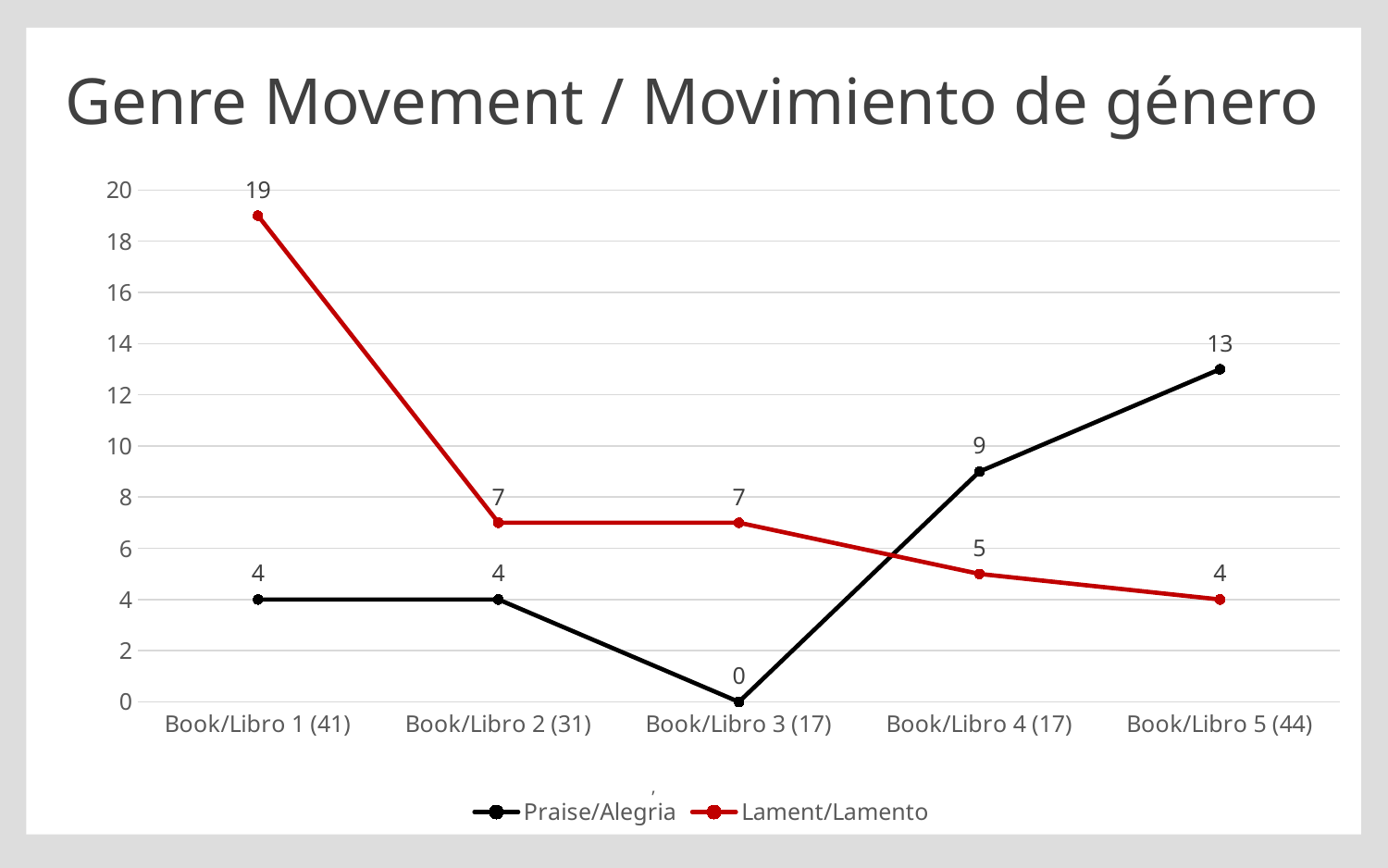
What is the Praise/Alegria value for Book/Libro 3 (17)? 0 Does the Lament/Lamento series rise or fall from Book/Libro 1 (41) to Book/Libro 5 (44)? Fall What kind of chart is shown on the slide? Line chart Which series has the larger value for Book/Libro 4 (17), Praise/Alegria or Lament/Lamento? Praise/Alegria How many categories are shown on the x axis? 5 What is the difference between the Lament/Lamento and Praise/Alegria values for Book/Libro 1 (41)? 15 Which category has the lowest Lament/Lamento value? Book/Libro 5 (44) Which category has the highest Praise/Alegria value? Book/Libro 5 (44) What is the Lament/Lamento value for Book/Libro 4 (17)? 5 How many series does the legend list? 2 What is the Praise/Alegria value for Book/Libro 5 (44)? 13 What is the Lament/Lamento value for Book/Libro 1 (41)? 19